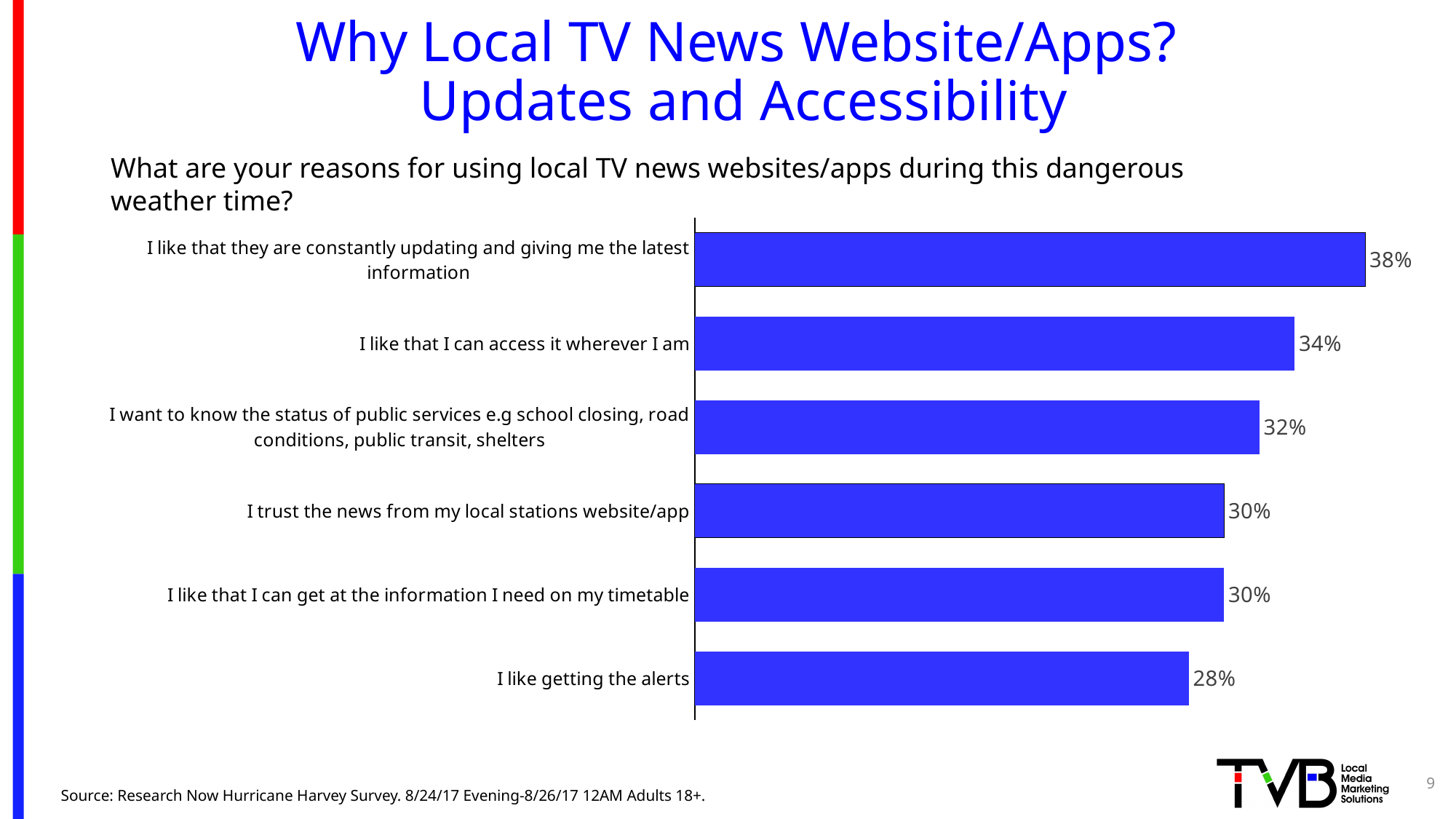
What percentage of respondents said they like that local TV news websites/apps are constantly updating and giving them the latest information? 38% What percentage of respondents said they want to know the status of public services? 32% Which reason has the highest percentage? I like that they are constantly updating and giving me the latest information What is the survey question shown above the chart? What are your reasons for using local TV news websites/apps during this dangerous weather time? What is the value for "I like that I can access it wherever I am"? 34% What is the value for "I like getting the alerts"? 28% How many reasons (categories) are shown in the chart? 6 Which is larger: the value for "I trust the news from my local stations website/app" or the value for "I like getting the alerts"? I trust the news from my local stations website/app How much higher is "I like that I can access it wherever I am" than "I like getting the alerts"? 6 percentage points Which reason has the lowest percentage? I like getting the alerts What type of chart is shown on the slide? Bar chart What is the difference between the highest and lowest percentages shown? 10 percentage points